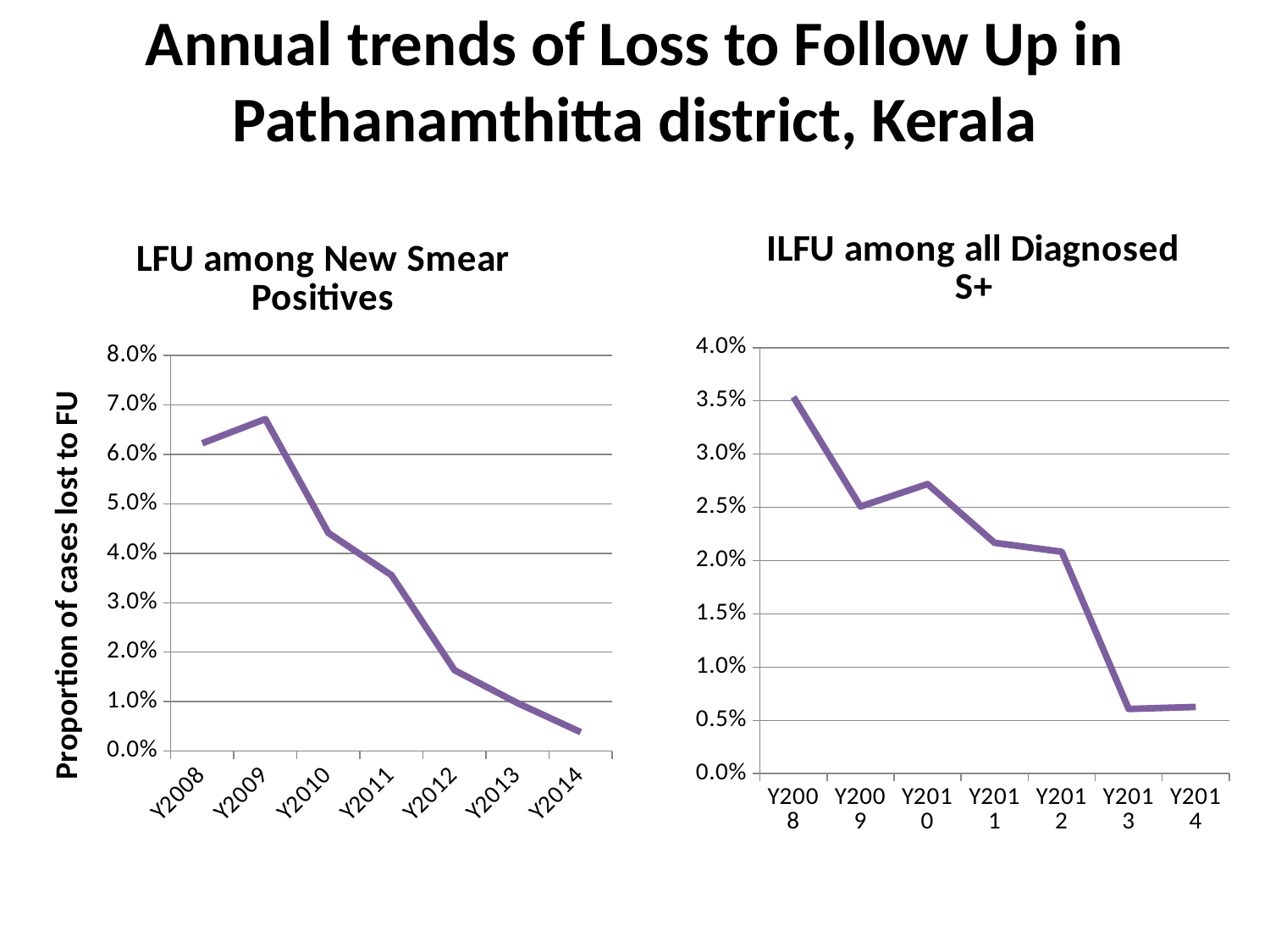
How many years are plotted in the 'LFU among New Smear Positives' chart? 7 In the 'ILFU among all Diagnosed S+' chart, is the value for Y2013 greater or less than 1.0%? less In the 'LFU among New Smear Positives' chart, which year has the lowest value? Y2014 In the 'LFU among New Smear Positives' chart, is the value for Y2012 greater or less than 2.0%? less In the 'LFU among New Smear Positives' chart, which year has the highest value? Y2009 Overall, do the values in the 'ILFU among all Diagnosed S+' chart rise or fall from Y2008 to Y2014? fall What kind of chart is the 'LFU among New Smear Positives' chart? line chart In the 'LFU among New Smear Positives' chart, which is larger, the value for Y2009 or the value for Y2010? Y2009 In the 'ILFU among all Diagnosed S+' chart, which year has the highest value? Y2008 What is the y-axis title of the 'LFU among New Smear Positives' chart? Proportion of cases lost to FU In the 'LFU among New Smear Positives' chart, is the value for Y2010 greater or less than 4.0%? greater